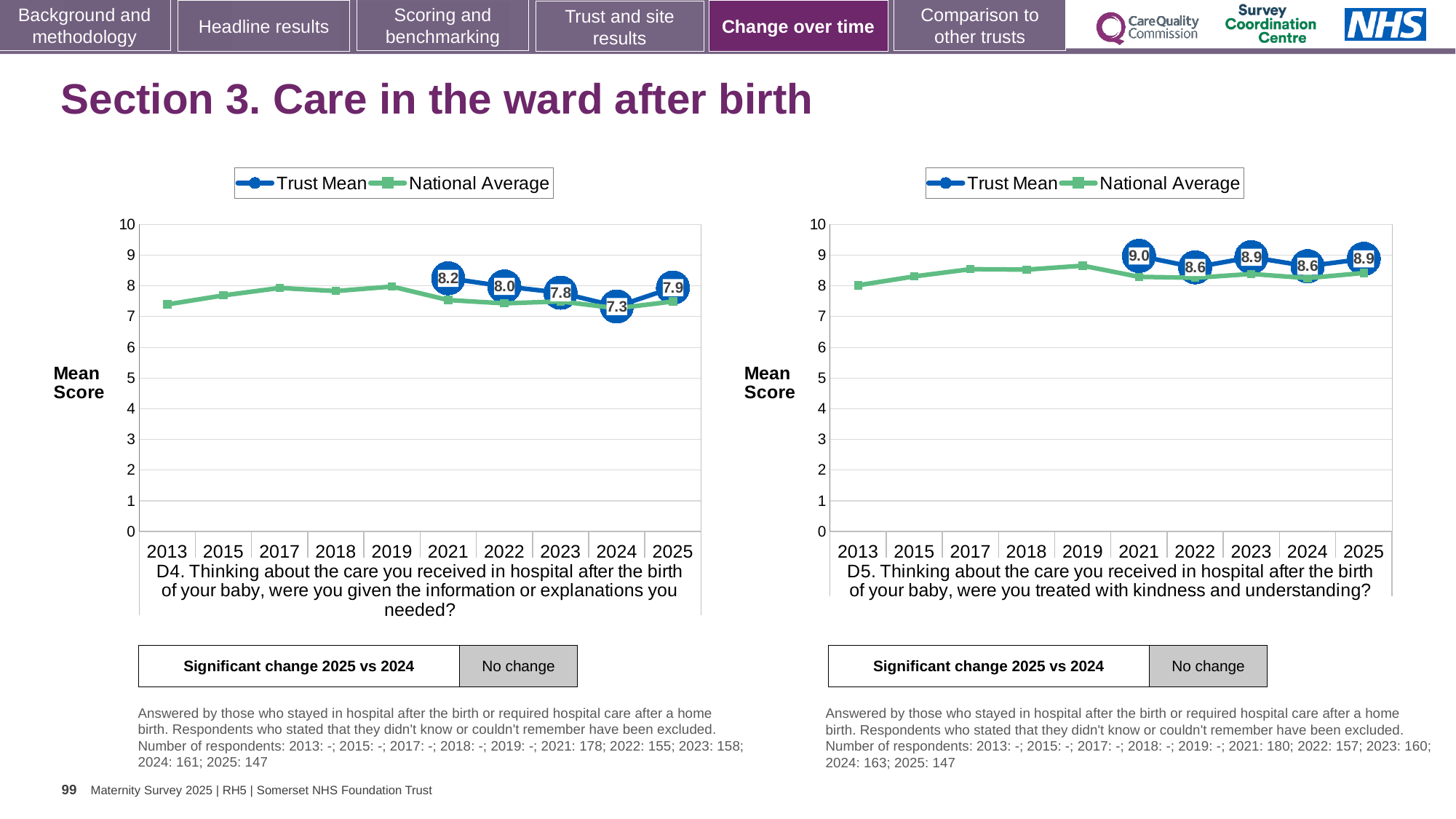
In the D5 chart on the right, what is the difference between the Trust Mean values for 2021 and 2022? 0.4 How many years are shown on the x axis of the D4 chart on the left? 10 In the D4 chart on the left, what is the difference between the Trust Mean values for 2021 and 2024? 0.9 In the D5 chart on the right, is the National Average value for 2019 greater or less than 8? greater In the D4 chart on the left, which year has the lowest Trust Mean value? 2024 How many series does the legend of the D5 chart on the right list? 2 In the D4 chart on the left, what is the Trust Mean value for 2021? 8.2 In the D5 chart on the right, which year has the highest Trust Mean value? 2021 In the D4 chart on the left, is the National Average value for 2013 greater or less than 8? less In the D5 chart on the right, what is the Trust Mean value for 2025? 8.9 In the D4 chart on the left, which is larger: the Trust Mean for 2024 or for 2025? 2025 In the D4 chart on the left, what is the Trust Mean value for 2024? 7.3